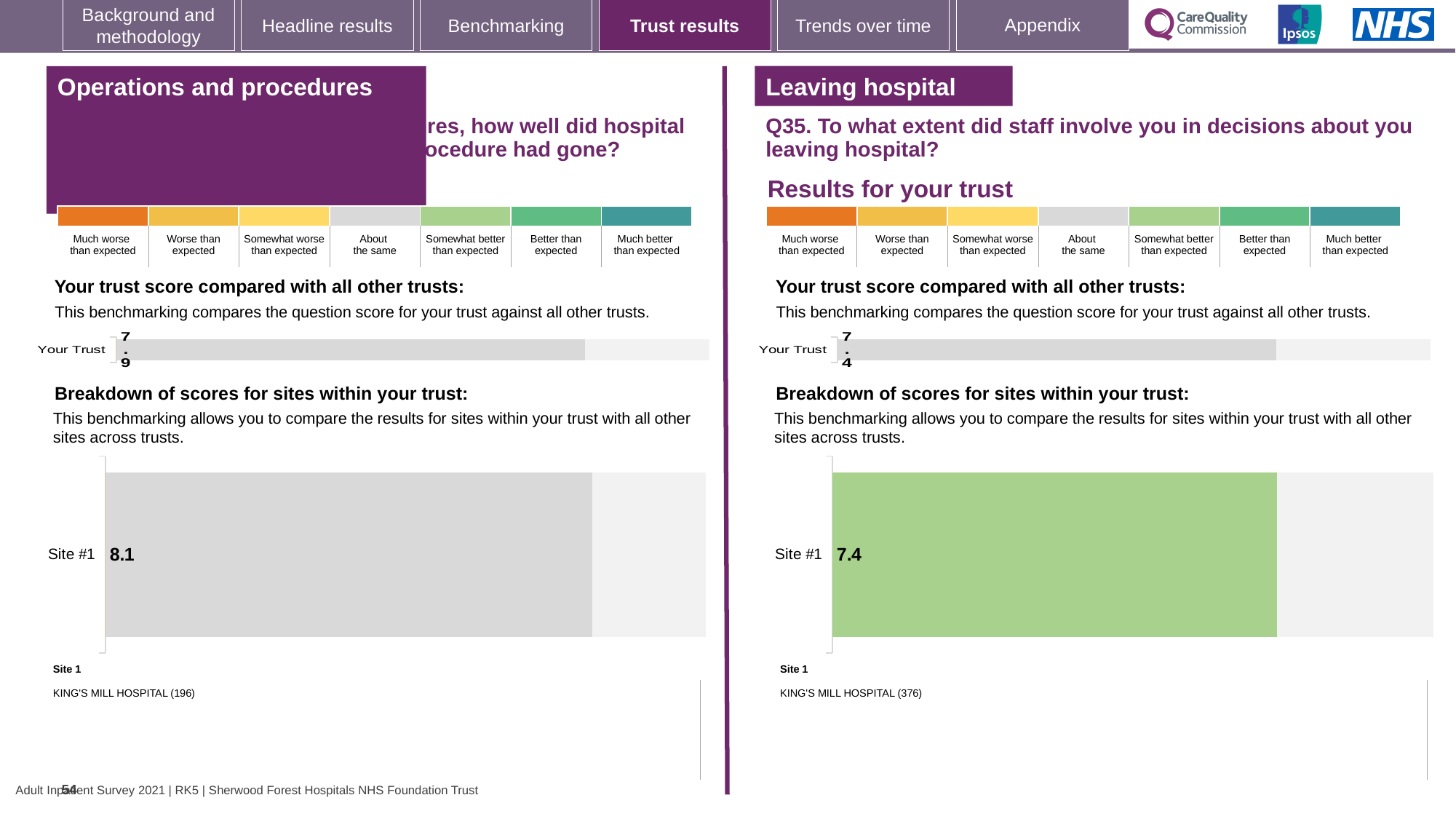
In the 'Operations and procedures' section, is the Site #1 score greater or less than 8? greater In the 'Leaving hospital' section, which hospital is listed as Site 1? KING'S MILL HOSPITAL (376) In the 'Leaving hospital' section, what is the 'Your Trust' score? 7.4 In the 'Operations and procedures' section, what is the score shown for Site #1? 8.1 In the 'Operations and procedures' section, what is the 'Your Trust' score? 7.9 In the 'Leaving hospital' section, what colour is the Site #1 bar? Green Which Site #1 score is higher: the one in the 'Operations and procedures' section or the one in the 'Leaving hospital' section? Operations and procedures What is the difference between the Site #1 score in the 'Operations and procedures' section and the Site #1 score in the 'Leaving hospital' section? 0.7 In the 'Leaving hospital' section, what is the score shown for Site #1? 7.4 In the 'Operations and procedures' section, what is the difference between the Site #1 score and the 'Your Trust' score? 0.2 How many sites are shown in the site breakdown chart in the 'Leaving hospital' section? 1 What type of chart is used to show the Site #1 score in the 'Leaving hospital' section? Bar chart